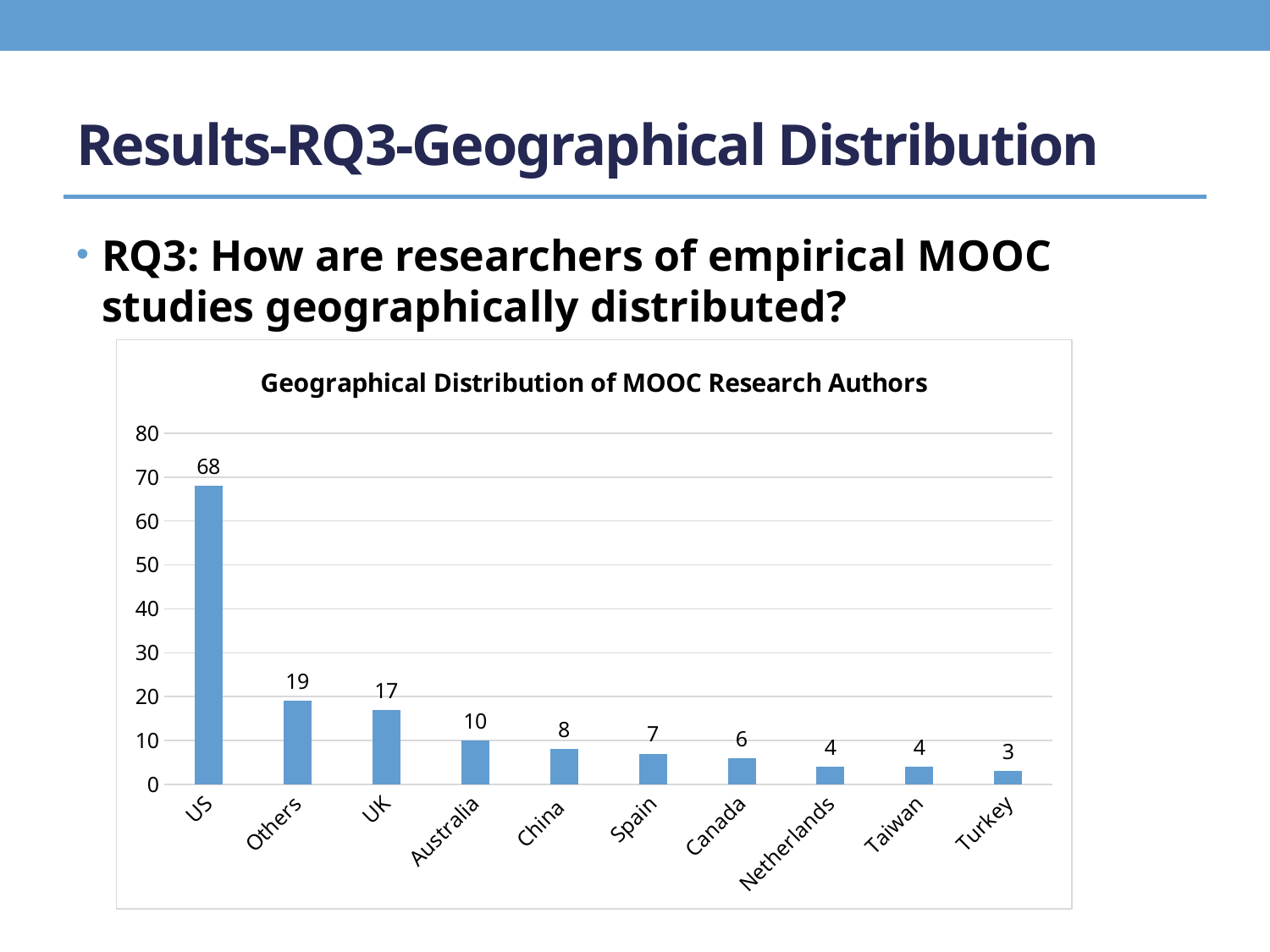
Which is larger, the value for Canada or the value for Spain? Spain What is the difference between the values for Others and the UK? 2 How many categories are shown on the x axis? 10 What is the value for Australia? 10 What is the title of the chart? Geographical Distribution of MOOC Research Authors What is the value for Spain? 7 What kind of chart is shown on the slide? bar chart Which category has the lowest value? Turkey What is the difference between the values for the US and China? 60 Is the value for the UK greater or less than 20? less Which category has the highest value? US What is the value for the US? 68